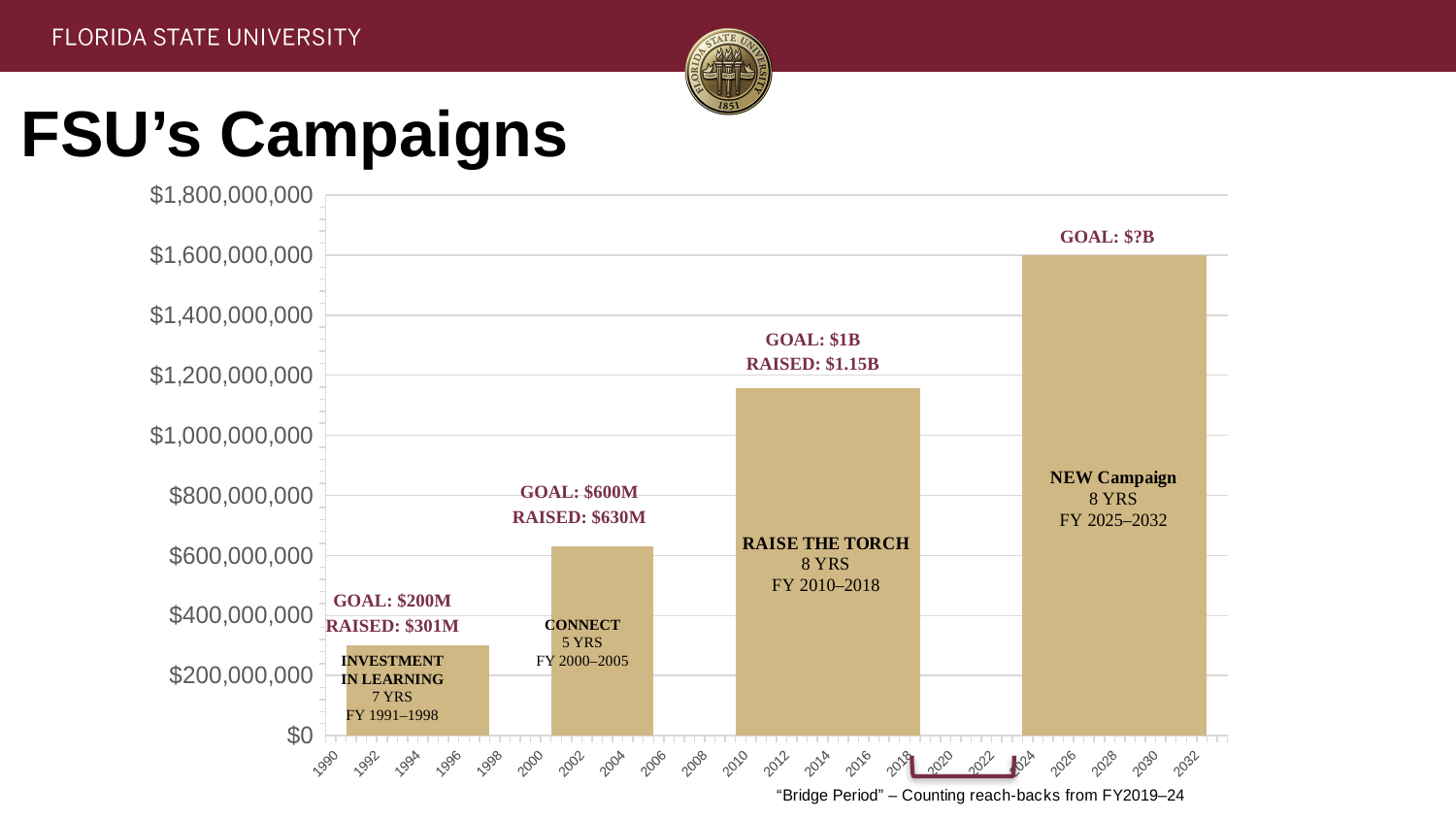
Which campaign has the tallest bar in the chart? NEW Campaign Which campaign has the shortest bar in the chart? INVESTMENT IN LEARNING How much did the INVESTMENT IN LEARNING campaign raise? $301M By how much did the CONNECT campaign exceed its goal? $30M How much did the CONNECT campaign raise? $630M What was the goal of the RAISE THE TORCH campaign? $1B Do the bar heights rise or fall from left to right across the chart? rise How much did the RAISE THE TORCH campaign raise? $1.15B Is the value of the NEW Campaign bar greater or less than $1,400,000,000? greater What kind of chart is shown on the slide? bar chart How many campaigns are plotted as bars in the chart? 4 Which raised more money, CONNECT or RAISE THE TORCH? RAISE THE TORCH